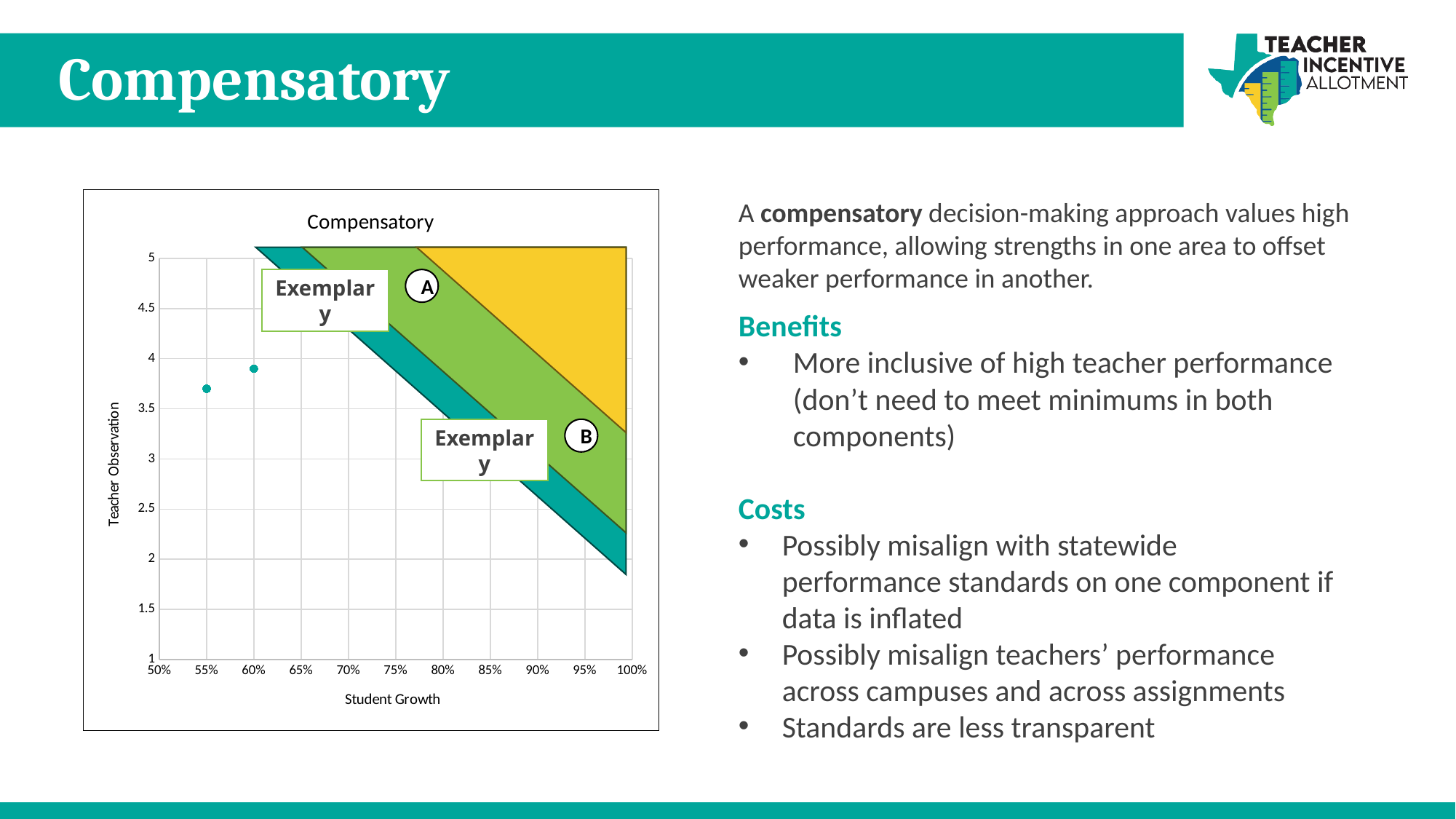
What is the label of the x axis of the chart? Student Growth What is the highest value shown on the x axis of the chart? 100% What is the Student Growth value of the leftmost plotted point? 55% What is the title of the chart? Compensatory Is the Teacher Observation value for the point at 60% Student Growth greater or less than 4? less Which plotted point has the higher Teacher Observation value, the one at 55% or the one at 60% Student Growth? 60% What kind of chart is shown on the slide? scatter chart What is the lowest value shown on the y axis of the chart? 1 Is the Teacher Observation value for the point at 55% Student Growth greater or less than 3.5? greater Do the plotted points rise or fall in Teacher Observation as Student Growth increases? rise